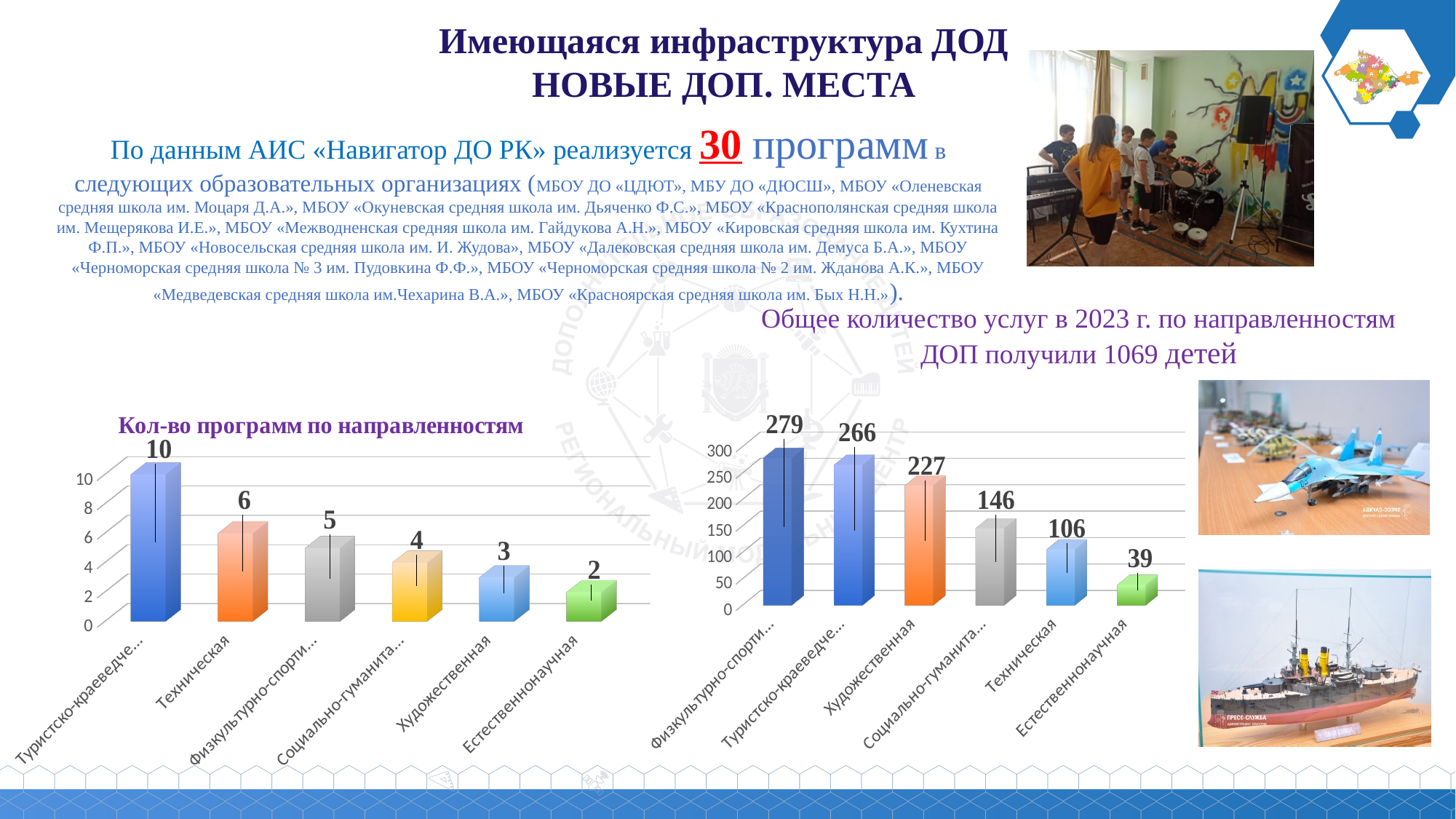
In the right chart (below «Общее количество услуг в 2023 г.»), what is the highest value shown? 279 In the right chart (below «Общее количество услуг в 2023 г.»), which is larger: Художественная or Техническая? Художественная In the left chart titled «Кол-во программ по направленностям», what is the value for Художественная? 3 In the right chart (below «Общее количество услуг в 2023 г.»), what is the value for Техническая? 106 In the right chart (below «Общее количество услуг в 2023 г.»), what is the value for Естественнонаучная? 39 In the left chart titled «Кол-во программ по направленностям», what is the value of the first (tallest) bar? 10 What type of chart is the left chart titled «Кол-во программ по направленностям»? Bar chart In the left chart titled «Кол-во программ по направленностям», what is the value for Техническая? 6 In the left chart titled «Кол-во программ по направленностям», which category has the lowest value? Естественнонаучная In the right chart (below «Общее количество услуг в 2023 г.»), what is the value for Художественная? 227 In the left chart titled «Кол-во программ по направленностям», what is the difference between Техническая and Естественнонаучная? 4 In the left chart titled «Кол-во программ по направленностям», how many categories are shown? 6